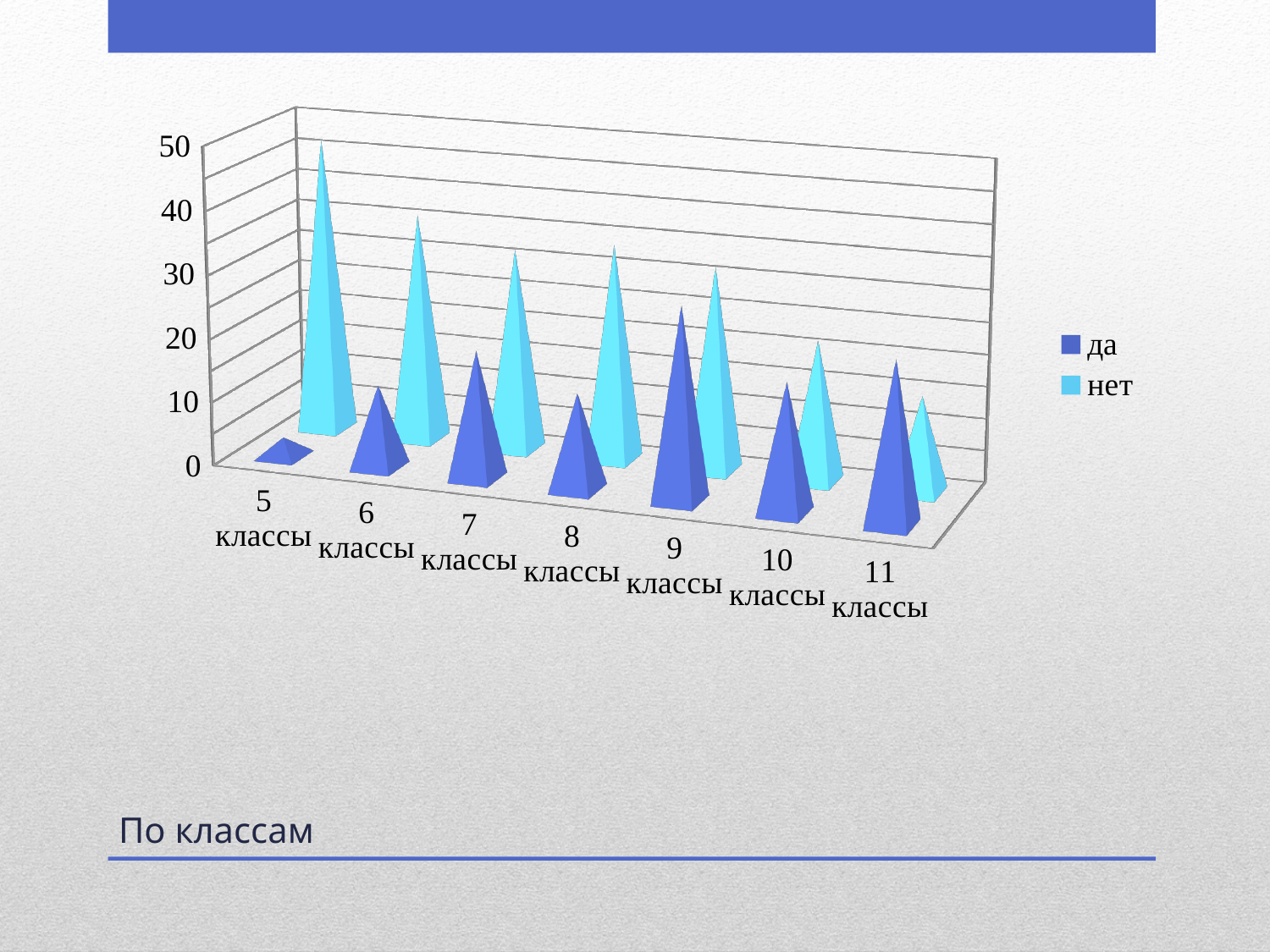
How many class categories are shown on the x axis? 7 What are the two entries listed in the legend? да, нет Which category has the highest value for the "да" series? 9 классы Which category has the highest value for the "нет" series? 5 классы Is the "нет" value for 11 классы greater or less than 30? less Do the values of the "нет" series generally rise or fall from 5 классы to 11 классы? fall Which category has the lowest value for the "да" series? 5 классы For 5 классы, which series has the larger value, "да" or "нет"? нет Is the "да" value for 5 классы greater or less than 10? less Is the "нет" value for 5 классы greater or less than 40? greater How many series does the legend list? 2 What kind of chart is shown on the slide? bar chart